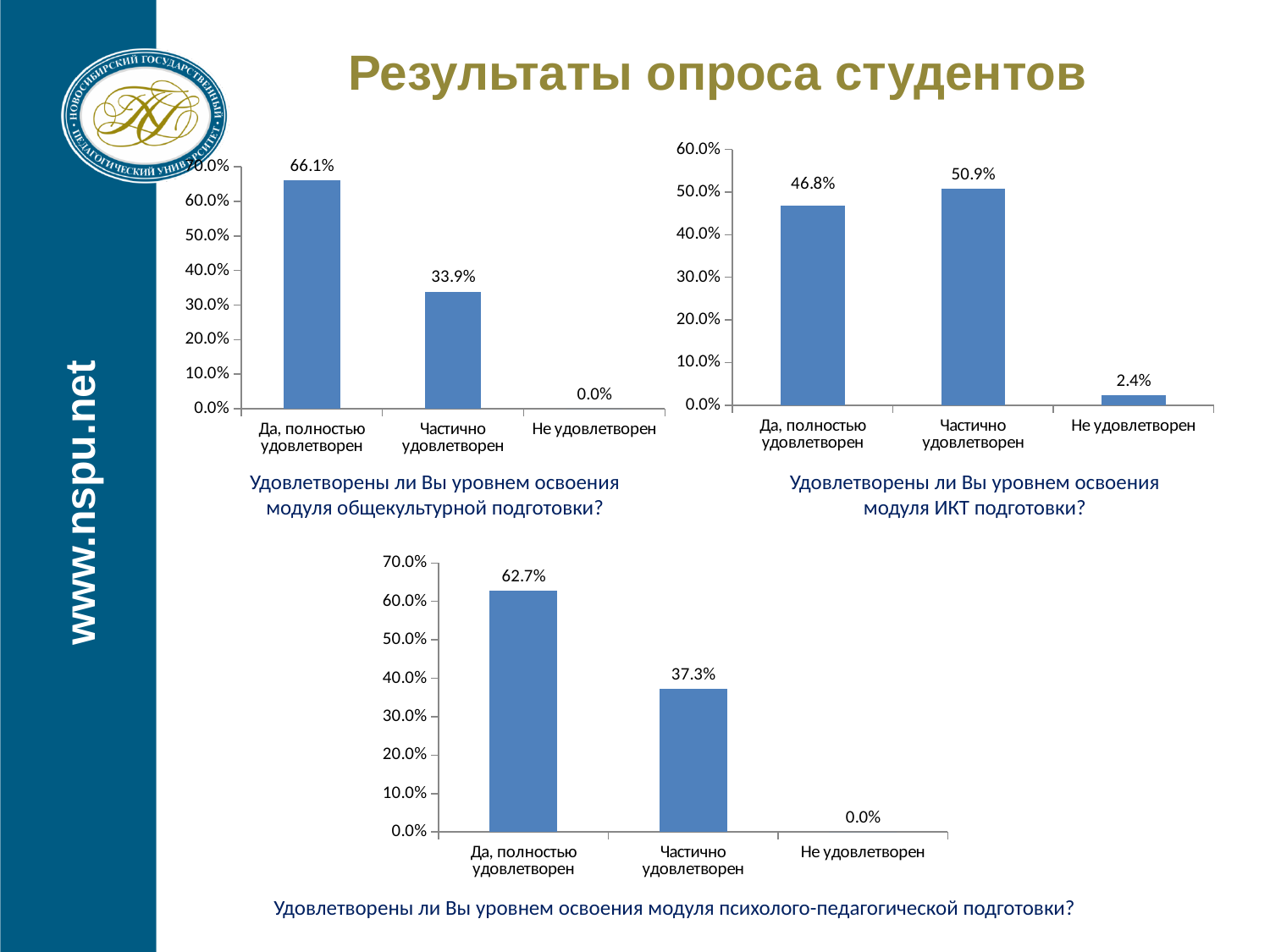
In the top-right chart (ИКТ подготовки), what is the value for "Частично удовлетворен"? 50.9% In the bottom chart (психолого-педагогической подготовки), which category has the lowest value? Не удовлетворен In the top-right chart (ИКТ подготовки), which category has the highest value? Частично удовлетворен In the bottom chart (психолого-педагогической подготовки), what is the value for "Частично удовлетворен"? 37.3% How many charts are shown on the slide? 3 In the bottom chart (психолого-педагогической подготовки), is the value for "Да, полностью удовлетворен" greater or less than 60.0%? greater How many categories are shown in the top-left chart (общекультурной подготовки)? 3 In the top-left chart (общекультурной подготовки), what is the value for "Да, полностью удовлетворен"? 66.1% In the top-right chart (ИКТ подготовки), which is larger: "Да, полностью удовлетворен" or "Частично удовлетворен"? Частично удовлетворен In the top-right chart (ИКТ подготовки), what is the value for "Не удовлетворен"? 2.4% In the top-left chart (общекультурной подготовки), what is the difference between "Да, полностью удовлетворен" and "Частично удовлетворен"? 32.2% What type of chart is the bottom chart (психолого-педагогической подготовки)? bar chart